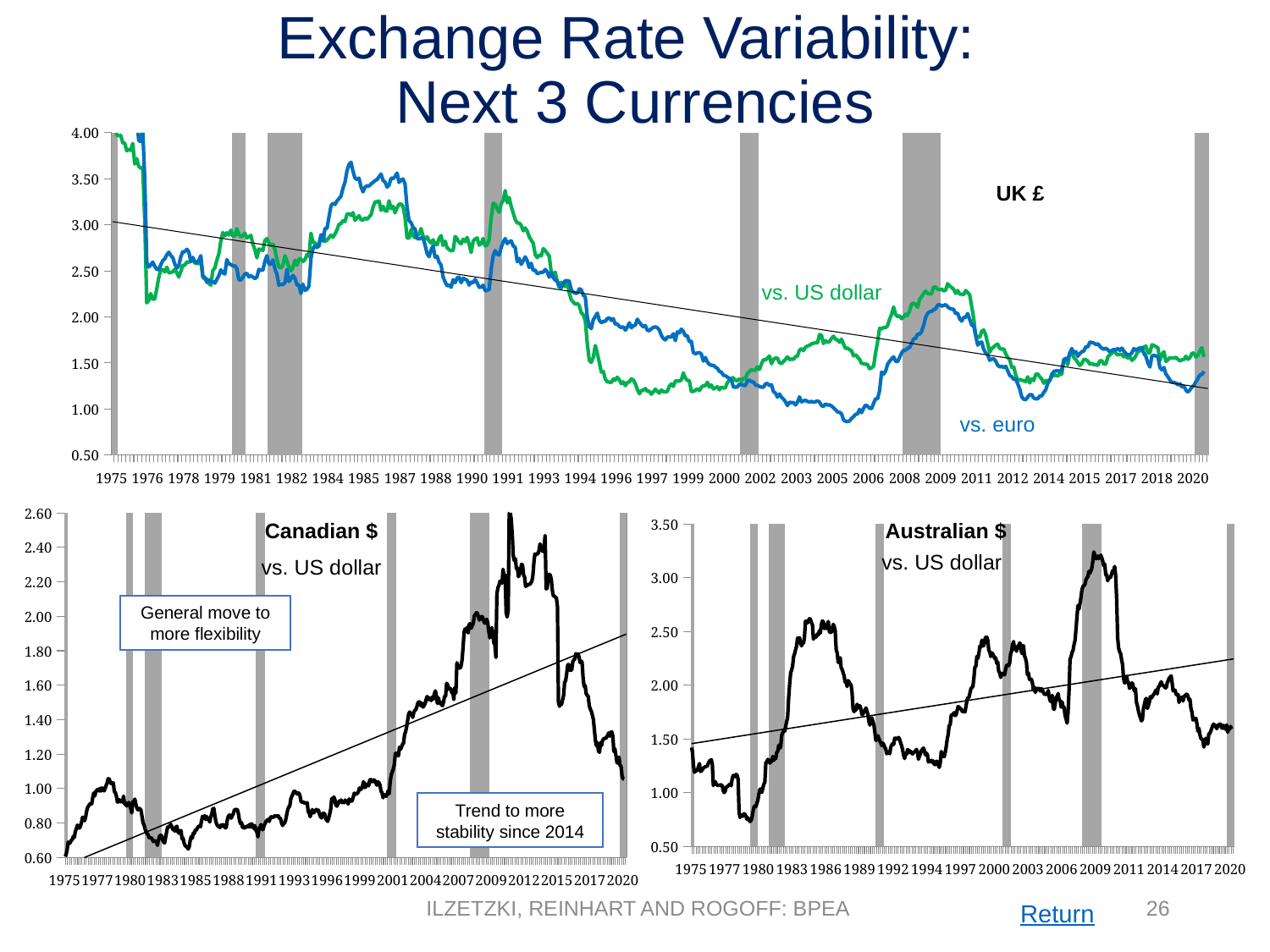
How many charts are shown on the slide? 3 In the Australian $ chart, is the peak value around 2009 greater or less than 3.00? greater In the Canadian $ chart, is the peak value around 2011 greater or less than 2.00? greater In the UK £ chart, how many series are plotted? 2 What kind of chart is the UK £ chart at the top of the slide? line chart In the UK £ chart, is the vs. US dollar value around 1996 greater or less than 2.00? less In the UK £ chart, what are the two series labelled? vs. US dollar and vs. euro In the Canadian $ chart, does the straight trend line rise or fall from 1975 to 2020? rise In the UK £ chart, does the straight trend line rise or fall from 1975 to 2020? fall In the UK £ chart, what colour is the vs. euro line? blue